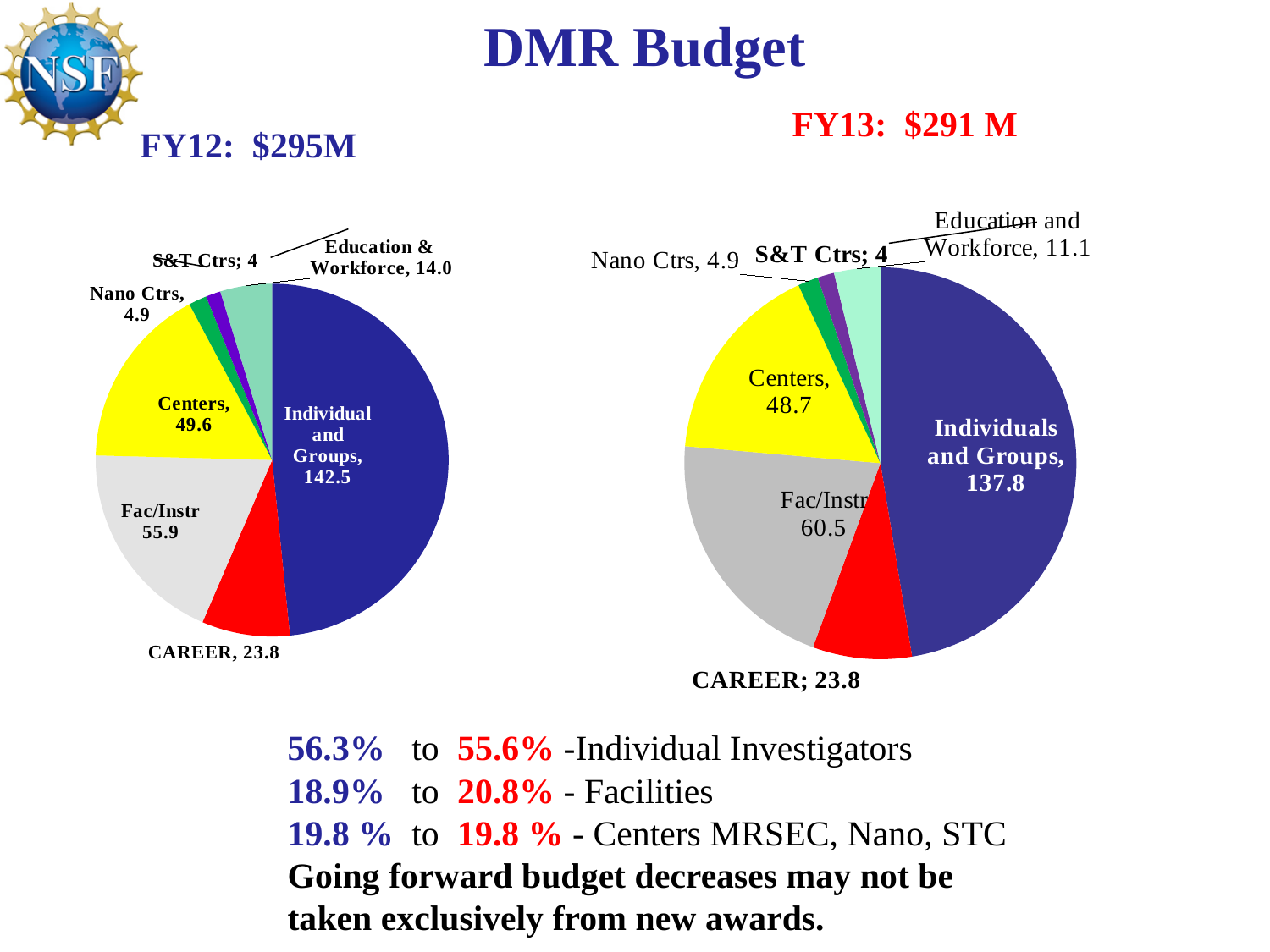
In the FY13 pie chart, what is the value for Fac/Instr? 60.5 In the FY13 pie chart, which category has the smallest slice? S&T Ctrs What kind of chart is the FY12 chart on the left? pie chart What is the difference between the Individual and Groups value in FY12 and the Individuals and Groups value in FY13? 4.7 In the FY12 pie chart, what is the value for Individual and Groups? 142.5 In the FY12 pie chart, what is the difference between Fac/Instr and Centers? 6.3 In the FY12 pie chart, which category has the largest slice? Individual and Groups In the FY13 pie chart, what is the value for Education and Workforce? 11.1 In the FY12 pie chart, what is the value for CAREER? 23.8 What colour is the Centers slice in the FY13 pie chart? yellow How many slices does the FY13 pie chart have? 7 In the FY13 pie chart, which is larger, Centers or Fac/Instr? Fac/Instr